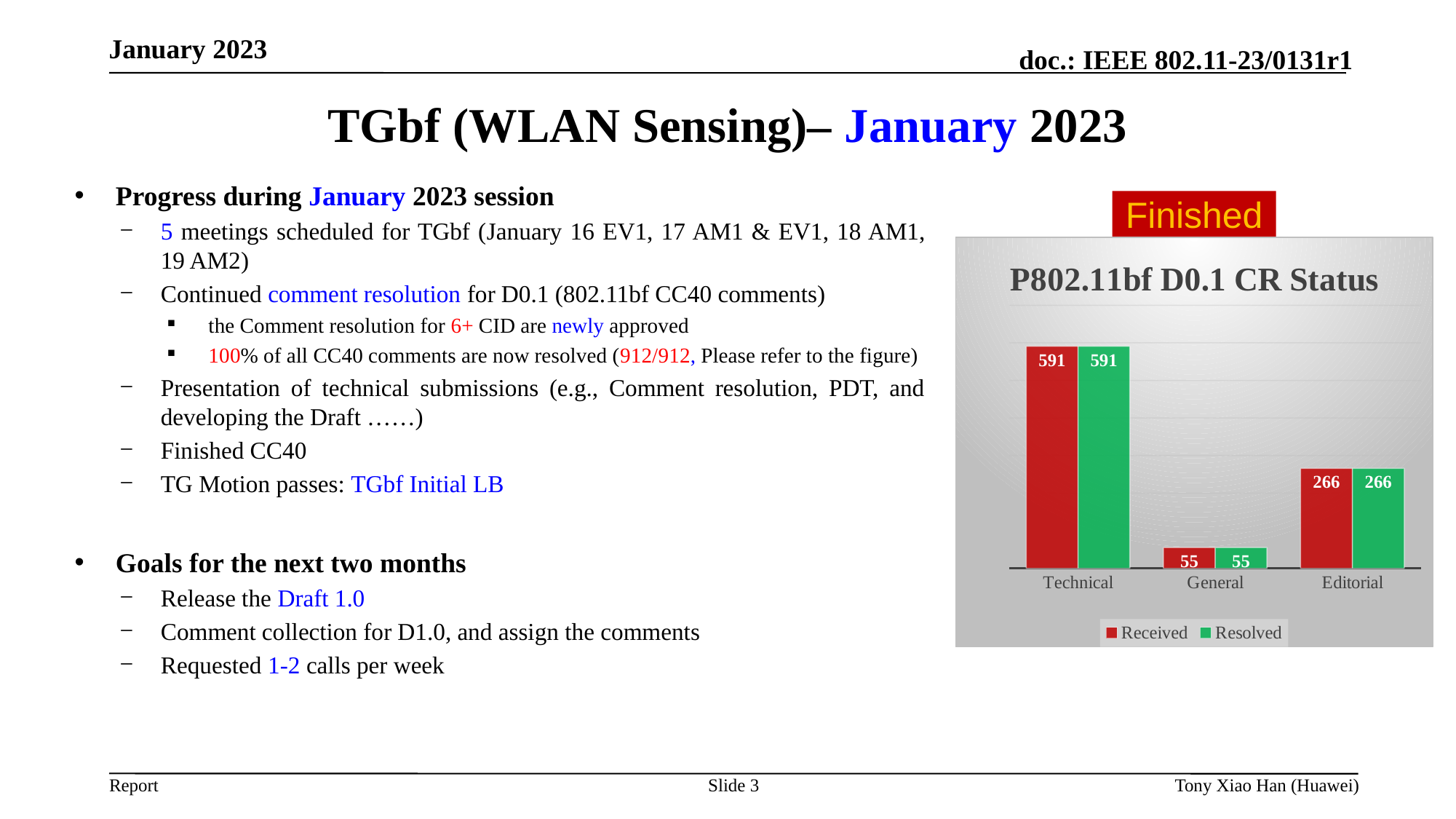
How many categories are shown on the x axis? 3 What is the Received value for Editorial? 266 What is the Resolved value for General? 55 Which is larger, the Received value for Editorial or the Received value for General? Editorial What is the Received value for Technical? 591 What is the difference between the Resolved values for Editorial and General? 211 Which category has the highest Received value? Technical What kind of chart is shown? bar chart What is the title of the chart? P802.11bf D0.1 CR Status How many series does the legend list? 2 Which category has the lowest Resolved value? General What is the difference between the Received values for Technical and Editorial? 325